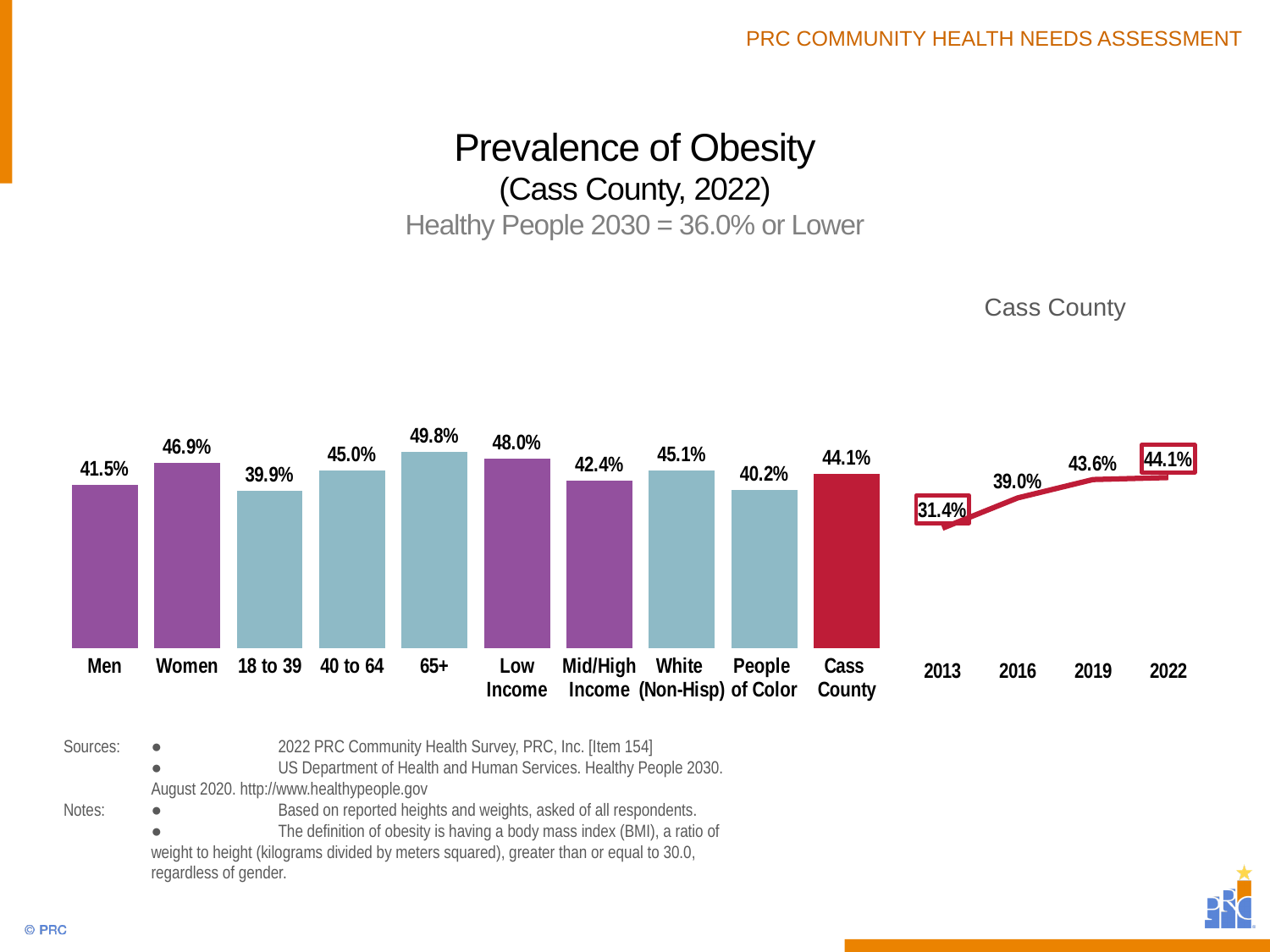
How many categories are shown in the bar chart on the left? 10 What kind of chart is the chart on the right showing Cass County from 2013 to 2022? line chart In the bar chart on the left, what is the difference between the values for Women and Men? 5.4% In the bar chart on the left, what is the value for Low Income? 48.0% In the line chart on the right, what was the value for 2019? 43.6% In the line chart on the right, do the values rise or fall from 2013 to 2022? rise In the line chart on the right, what was the prevalence of obesity in Cass County in 2013? 31.4% In the bar chart on the left, which category has the highest prevalence of obesity? 65+ In the bar chart on the left, which category has the lowest prevalence of obesity? 18 to 39 In the bar chart on the left, which is larger, the value for White (Non-Hisp) or the value for People of Color? White (Non-Hisp) In the bar chart on the left, what is the prevalence of obesity for Women? 46.9% In the line chart on the right, what is the difference between the 2022 and 2013 values? 12.7%